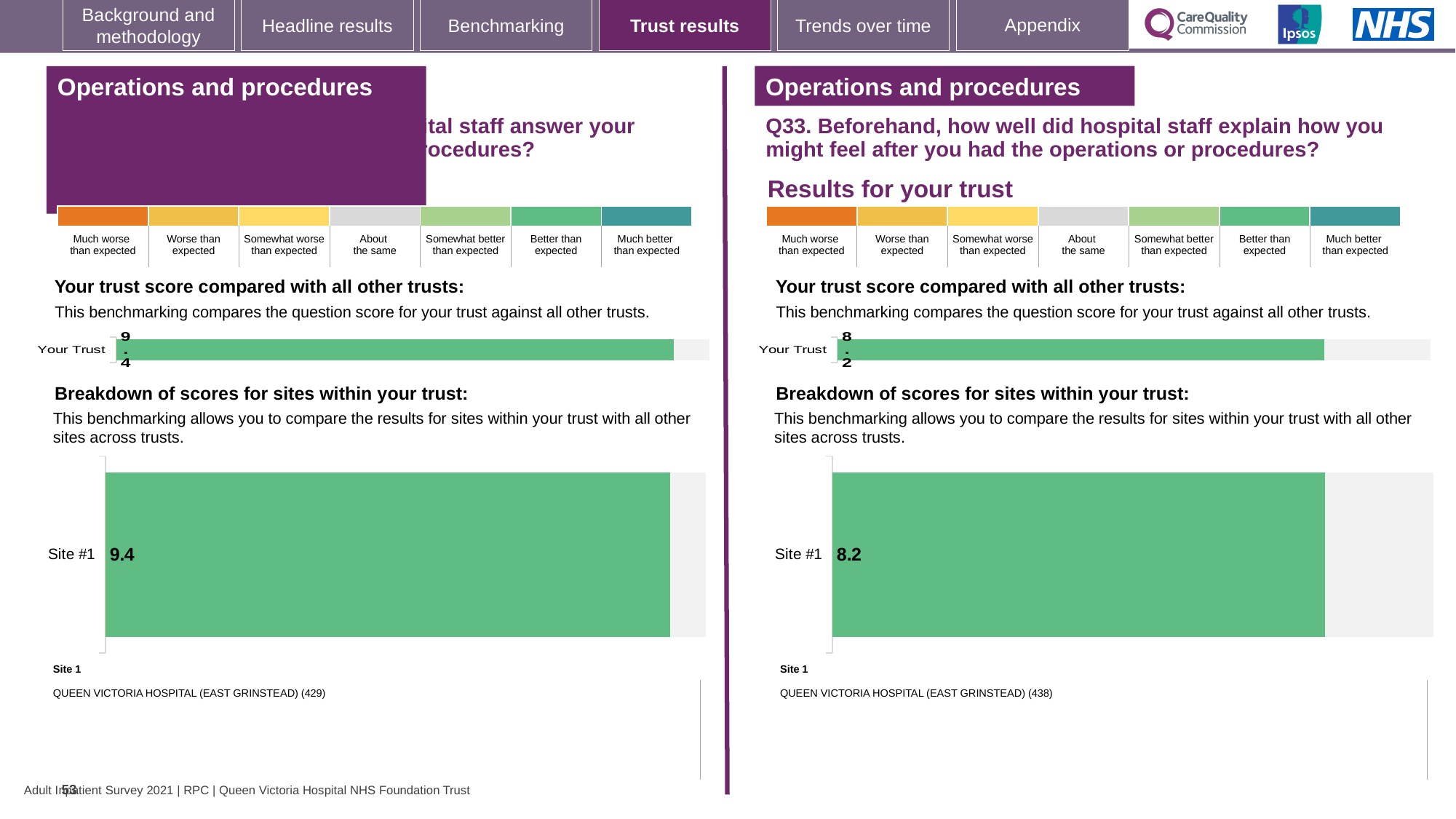
What is the difference between the Site #1 score in the left panel (9.4) and the Site #1 score in the right panel (8.2)? 1.2 What type of chart is used to show the Site #1 score in the right panel (Q33)? Bar chart In the left panel, what score is shown for Site #1 in the 'Breakdown of scores for sites within your trust' chart? 9.4 In the right panel (Q33), what is the score shown for Your Trust in the 'Your trust score compared with all other trusts' chart? 8.2 In the right panel (Q33), which hospital is listed as Site 1 below the breakdown chart? QUEEN VICTORIA HOSPITAL (EAST GRINSTEAD) (438) In the left panel, how many bars are plotted in the 'Breakdown of scores for sites within your trust' chart? 1 Which panel shows the higher Your Trust score, the left panel or the right panel (Q33)? Left panel Which panel shows the higher Site #1 score, the left panel or the right panel (Q33)? Left panel In the left panel, what is the score shown for Your Trust in the 'Your trust score compared with all other trusts' chart? 9.4 In the right panel (Q33), what score is shown for Site #1 in the 'Breakdown of scores for sites within your trust' chart? 8.2 In the right panel (Q33), how many sites are shown in the 'Breakdown of scores for sites within your trust' chart? 1 In the right panel (Q33), what colour is the Site #1 bar? Green